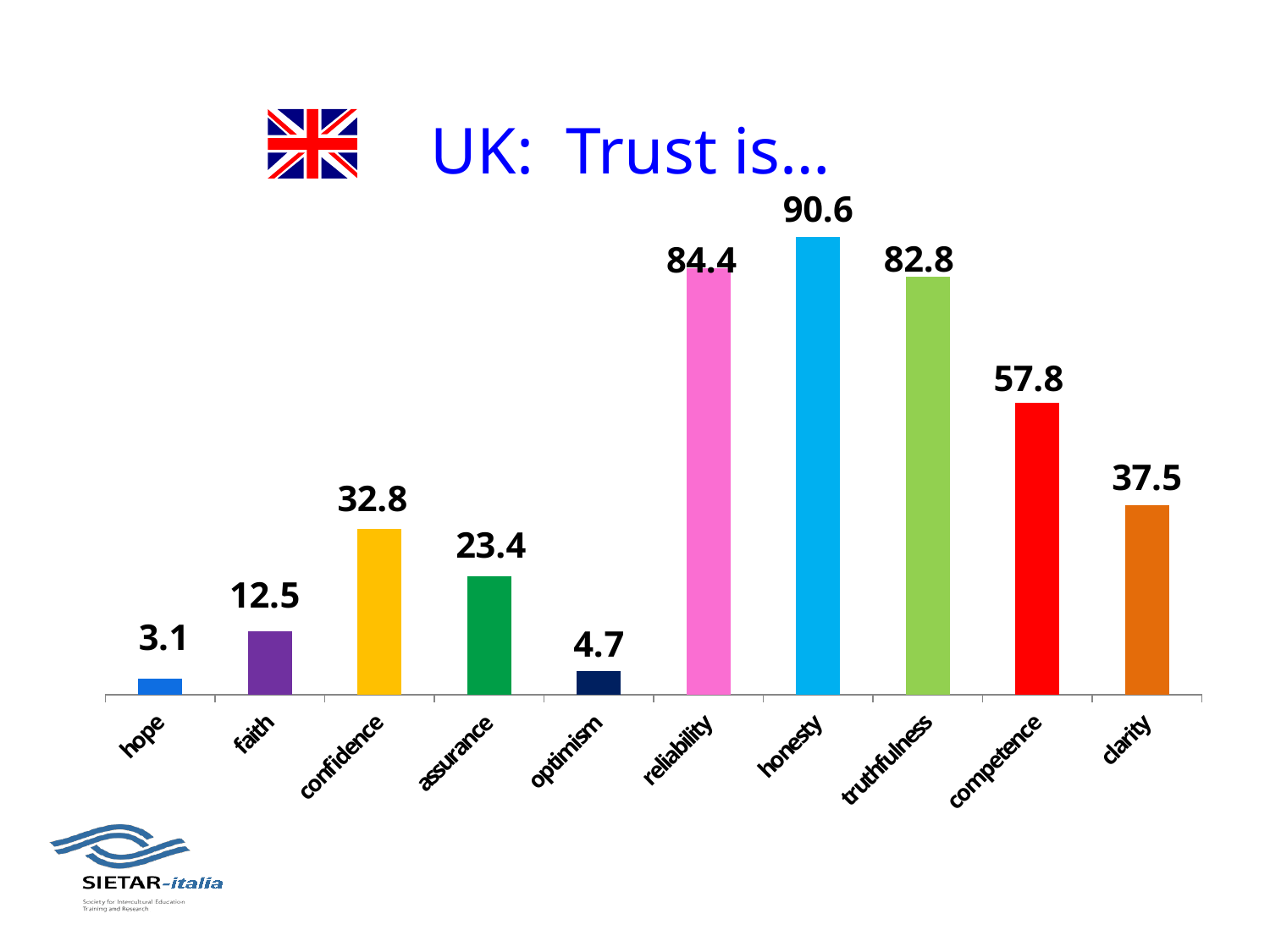
What kind of chart is shown on the slide? bar chart Which is larger, the value for faith or the value for assurance? assurance Which is larger, the value for reliability or the value for truthfulness? reliability How many categories are shown on the x axis? 10 What is the value for optimism? 4.7 What is the title of the slide? UK: Trust is... What is the value for honesty? 90.6 What is the difference between the values for competence and clarity? 20.3 Which category has the highest value? honesty Which category has the lowest value? hope What is the value for confidence? 32.8 What is the difference between the values for honesty and truthfulness? 7.8